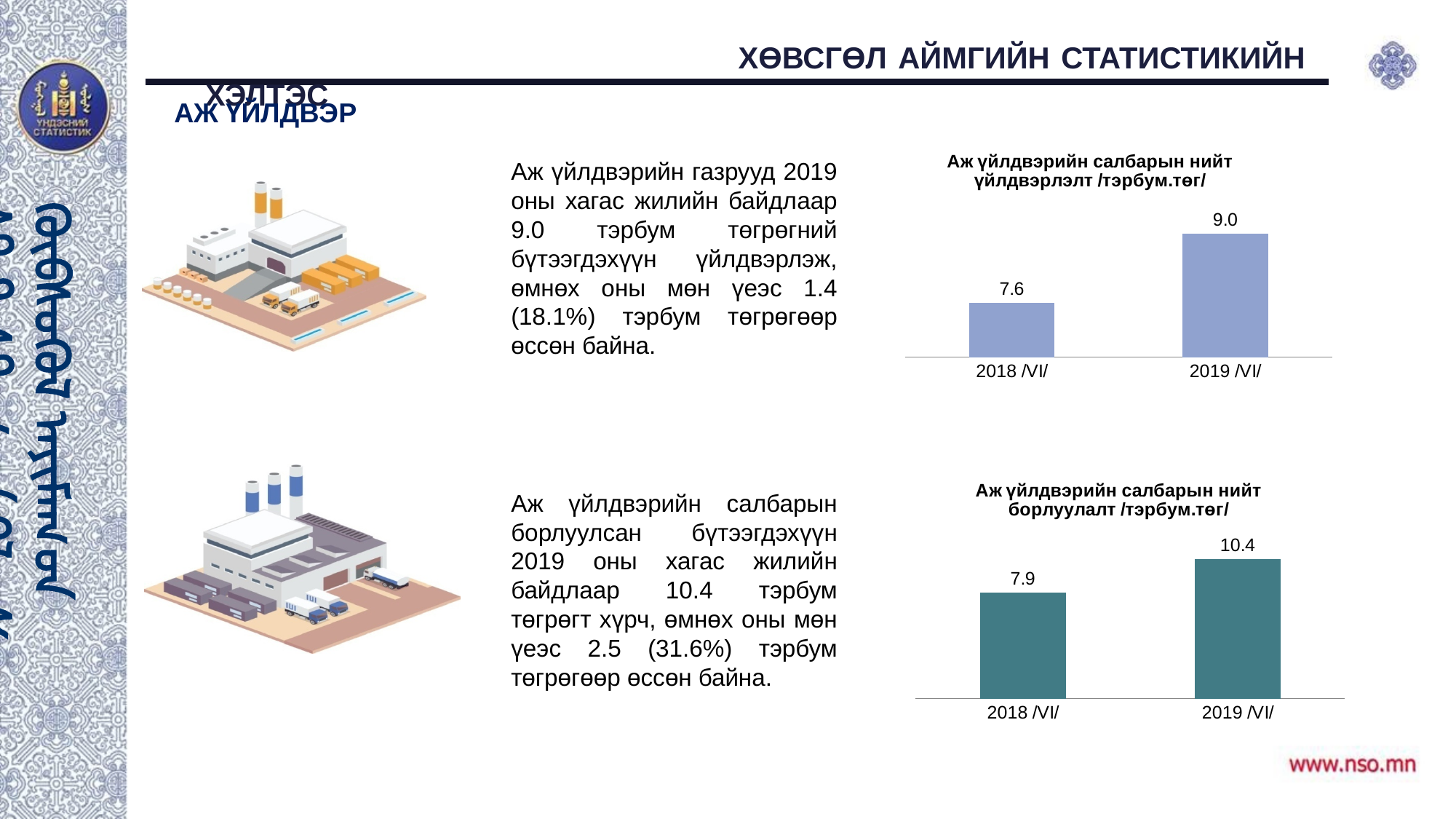
In the bottom chart (Аж үйлдвэрийн салбарын нийт борлуулалт), what is the value for 2019 /VI/? 10.4 In the top chart, which period has the higher value? 2019 /VI/ In the top chart (Аж үйлдвэрийн салбарын нийт үйлдвэрлэлт), what is the value for 2019 /VI/? 9.0 In the top chart (Аж үйлдвэрийн салбарын нийт үйлдвэрлэлт), what is the value for 2018 /VI/? 7.6 What kind of chart is the bottom chart (Аж үйлдвэрийн салбарын нийт борлуулалт)? Bar chart In the top chart, do the values rise or fall from 2018 /VI/ to 2019 /VI/? Rise How many bars are shown in the top chart? 2 In the bottom chart (Аж үйлдвэрийн салбарын нийт борлуулалт), what is the value for 2018 /VI/? 7.9 In the bottom chart, which period has the lower value? 2018 /VI/ In the bottom chart, which is larger: the value for 2018 /VI/ or 2019 /VI/? 2019 /VI/ In the top chart, what is the difference between the 2019 /VI/ and 2018 /VI/ values? 1.4 In the bottom chart, what is the difference between the 2019 /VI/ and 2018 /VI/ values? 2.5